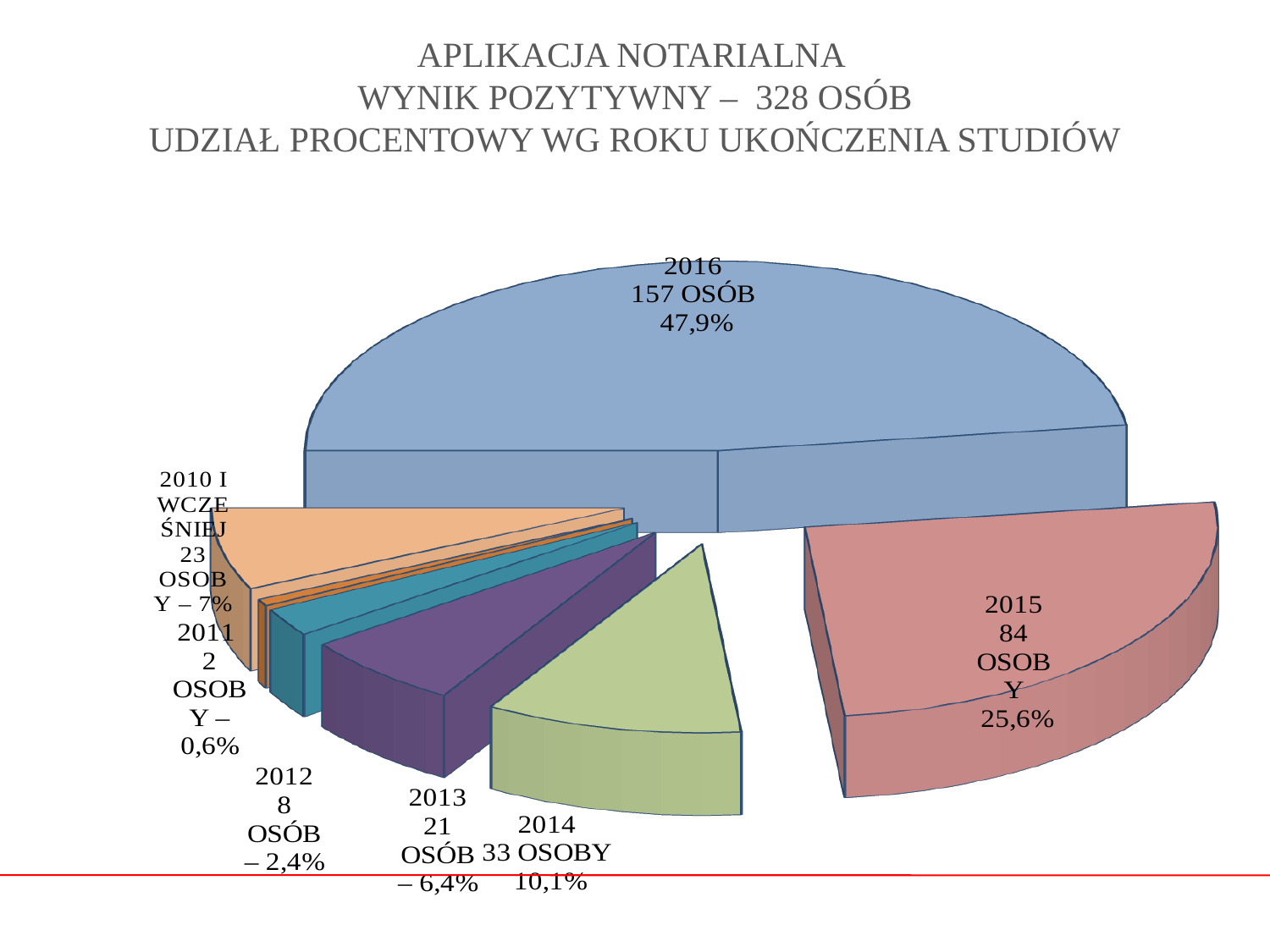
Which category has the smallest slice of the pie? 2011 How many people are shown for 2011? 2 What percentage share is shown for 2012? 2,4% What kind of chart is shown on the slide? Pie chart What percentage share is shown for 2014? 10,1% How many people are shown for 2013? 21 What is the difference in number of people between 2016 and 2015? 73 What percentage share is shown for 2015? 25,6% How many slices does the pie chart have? 7 How many people (osób) are shown for 2016? 157 Which year has the largest slice of the pie? 2016